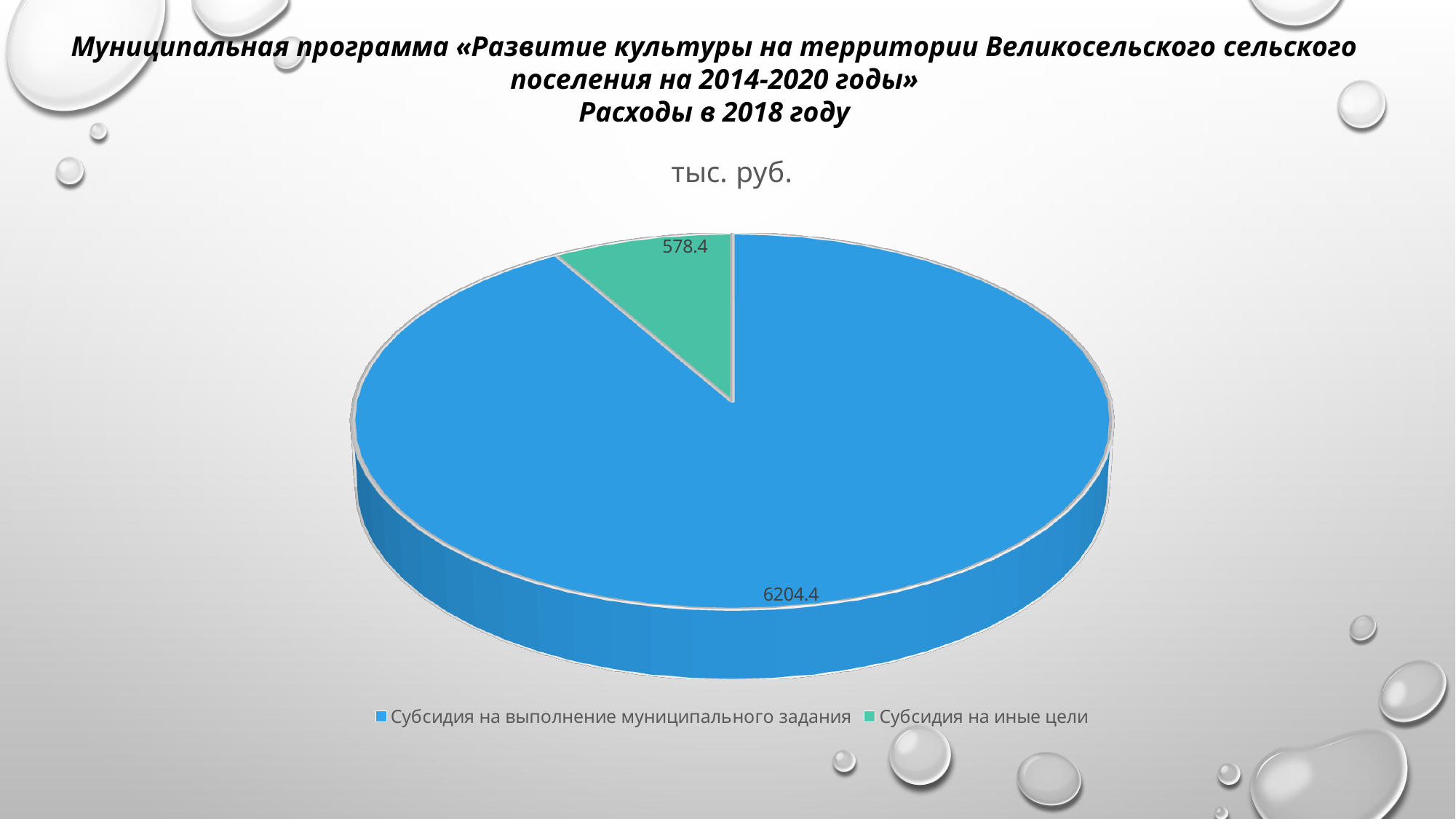
What is the total of the two values shown in the pie chart? 6782.8 What is the value for Субсидия на выполнение муниципального задания? 6204.4 What is the difference between the value for Субсидия на выполнение муниципального задания and the value for Субсидия на иные цели? 5626.0 What is the title of the chart? тыс. руб. Which is larger: Субсидия на выполнение муниципального задания or Субсидия на иные цели? Субсидия на выполнение муниципального задания How many entries does the legend list? 2 How many slices does the pie chart have? 2 Which category has the largest slice of the pie? Субсидия на выполнение муниципального задания What colour is the slice for Субсидия на иные цели? green What is the value for Субсидия на иные цели? 578.4 What type of chart is shown on the slide? pie chart Which category has the smallest slice of the pie? Субсидия на иные цели